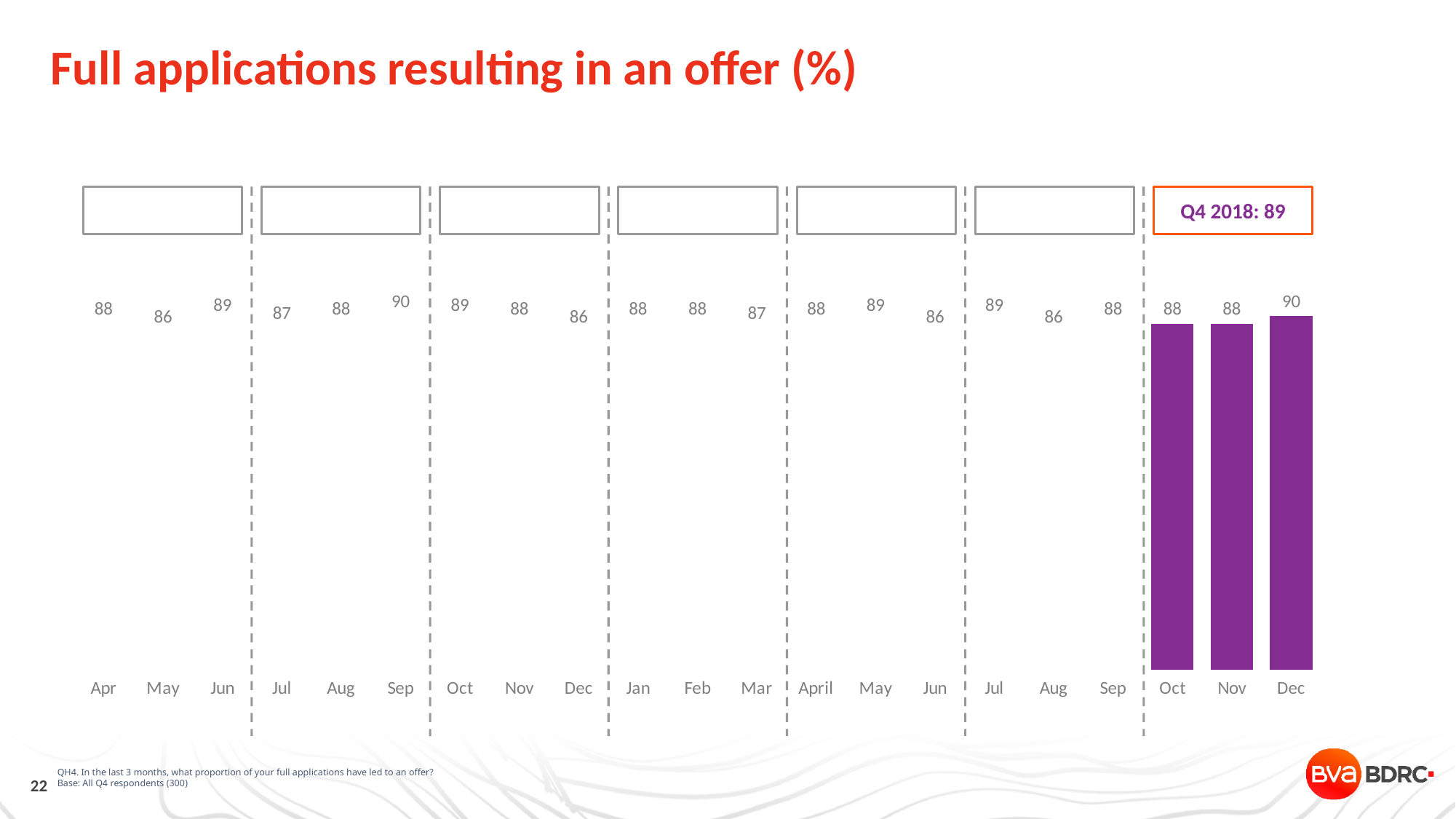
What is the value for Mar? 87 Among the three purple bars (Oct, Nov, Dec of Q4 2018), which month has the highest value? Dec What kind of chart is shown on the slide? bar chart What value is shown in the highlighted box for Q4 2018? 89 What is the title of the chart? Full applications resulting in an offer (%) How many month categories are shown along the x axis in total? 21 What is the value for Oct in the final (Q4 2018) group of purple bars? 88 Do the values across the three purple bars (Oct, Nov, Dec of Q4 2018) rise or fall from left to right? rise In the Q4 2018 group, what is the difference between the Dec value and the Oct value? 2 What is the value for Jan? 88 In the Q4 2018 group, is the value for Dec larger or smaller than the value for Nov? larger What is the value for Dec in the final (Q4 2018) group of purple bars? 90